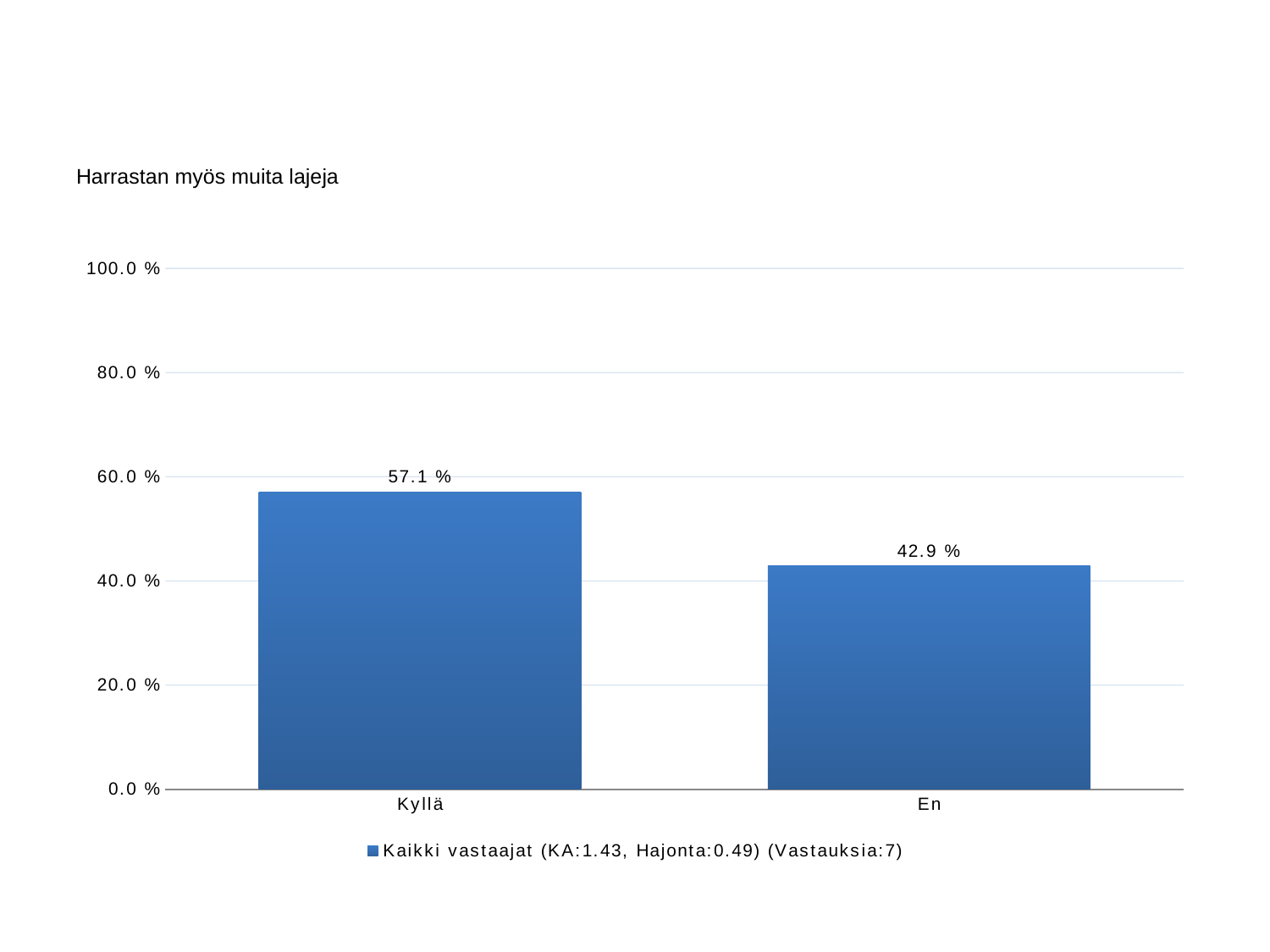
Which category has the highest value? Kyllä How many series does the legend list? 1 What is the value for En? 42.9 % What kind of chart is shown? bar chart What is the difference between the values for Kyllä and En? 14.2 % What is the value for Kyllä? 57.1 % Is the value for Kyllä greater or less than 60.0 %? less What is the title of the chart? Harrastan myös muita lajeja Is the value for En greater or less than 40.0 %? greater Which is larger, the value for Kyllä or the value for En? Kyllä How many categories are shown on the x axis? 2 Which category has the lowest value? En